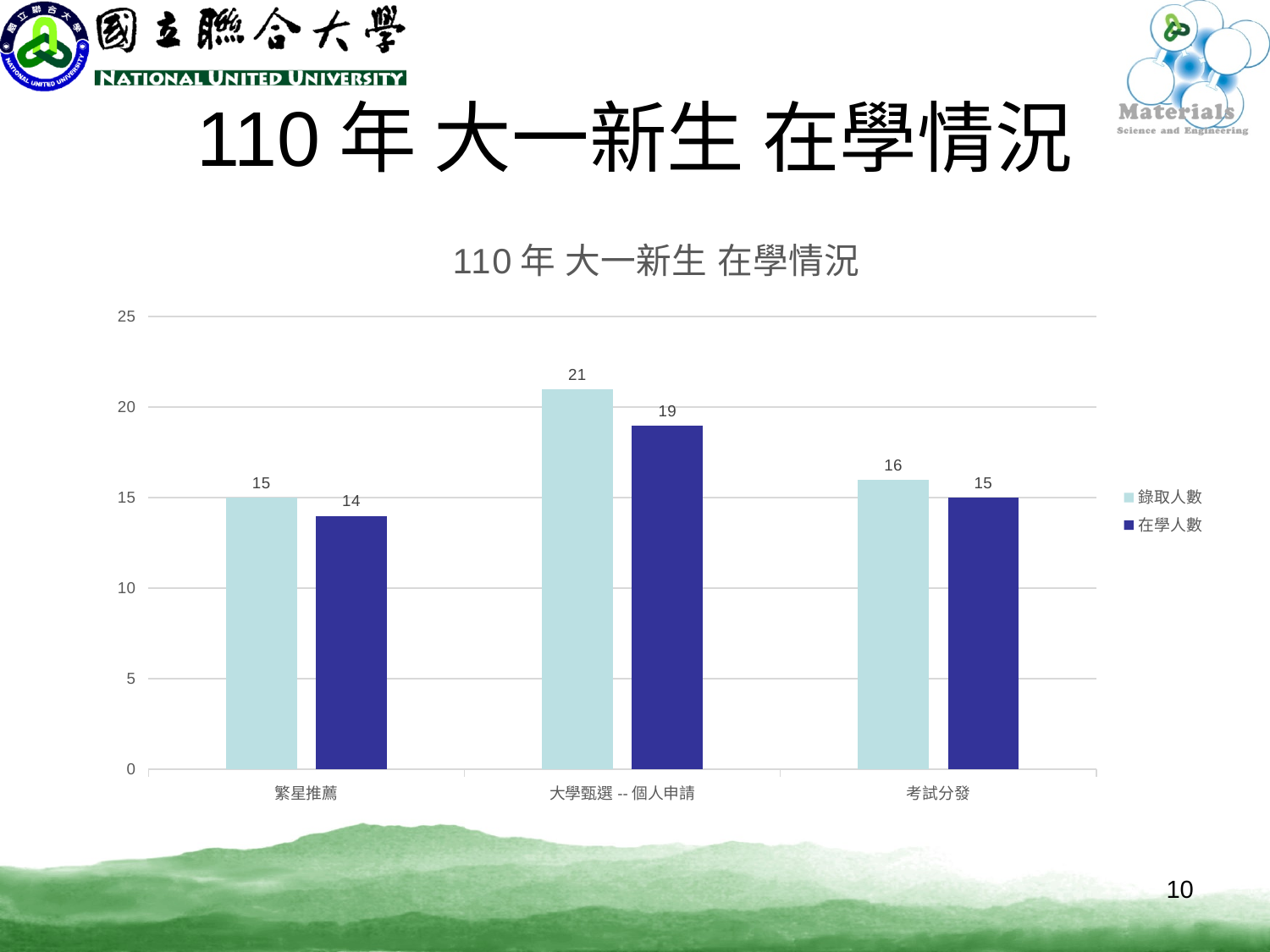
What is the 在學人數 value for 考試分發? 15 What is the difference between 錄取人數 and 在學人數 for 大學甄選 -- 個人申請? 2 How many series does the legend list? 2 What is the 在學人數 value for 繁星推薦? 14 What is the title of the chart? 110 年 大一新生 在學情況 How many categories are shown on the x axis? 3 Which category has the lowest 在學人數? 繁星推薦 What is the difference in 錄取人數 between 大學甄選 -- 個人申請 and 繁星推薦? 6 Which category has the highest 錄取人數? 大學甄選 -- 個人申請 What is the 錄取人數 value for 大學甄選 -- 個人申請? 21 What kind of chart is shown on the slide? bar chart Which is larger: the 錄取人數 for 考試分發 or the 錄取人數 for 繁星推薦? 考試分發